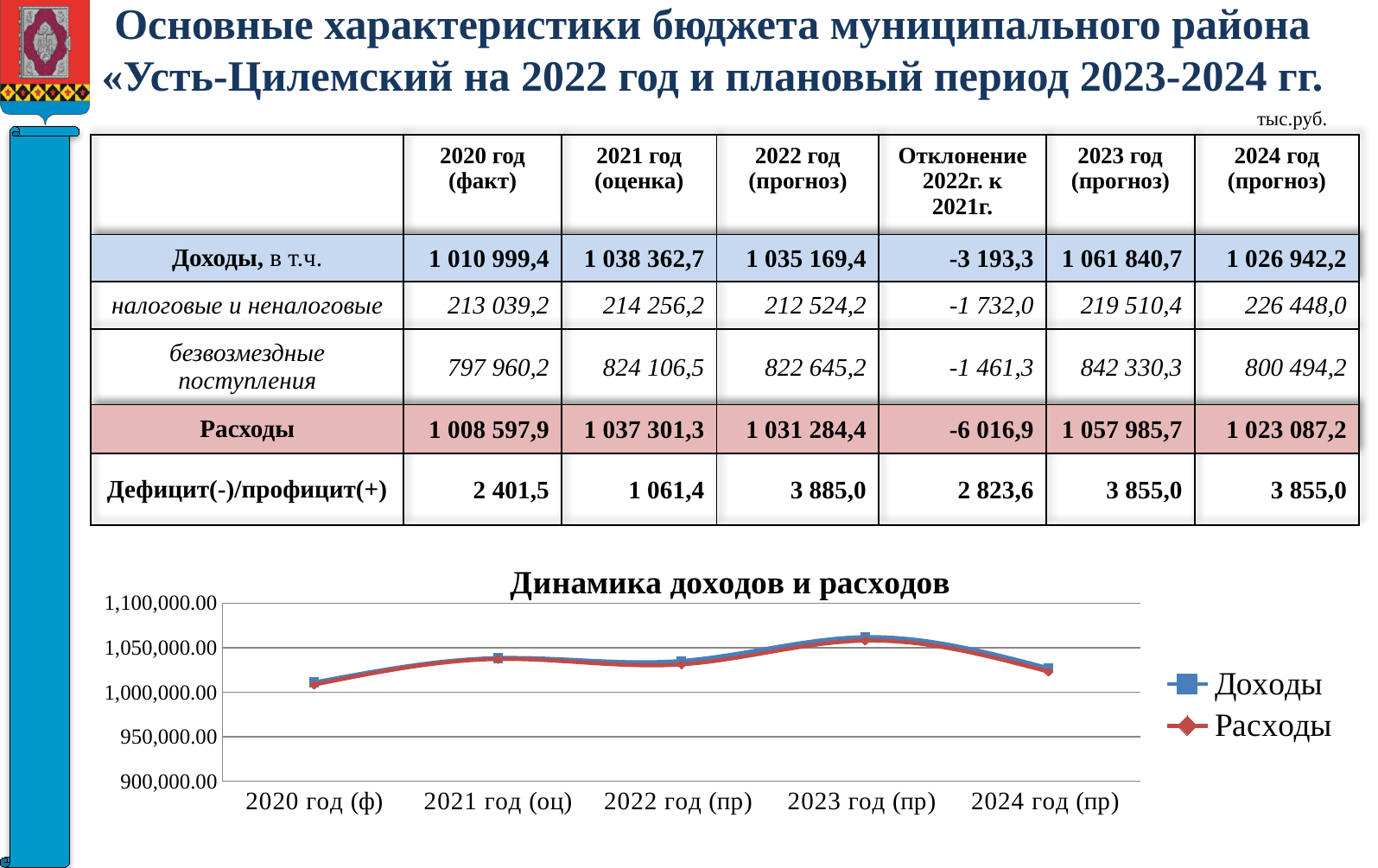
What kind of chart is shown under the title "Динамика доходов и расходов"? line chart In the chart "Динамика доходов и расходов", which series is drawn in red? Расходы In the chart "Динамика доходов и расходов", is the value for Расходы in 2020 год (ф) greater or less than 1,050,000.00? less In the chart "Динамика доходов и расходов", do the Доходы values rise or fall from 2023 год (пр) to 2024 год (пр)? fall In the chart "Динамика доходов и расходов", which year has the highest value for Расходы? 2023 год (пр) In the chart "Динамика доходов и расходов", do the Расходы values rise or fall from 2020 год (ф) to 2021 год (оц)? rise How many points are plotted along the x axis of the chart "Динамика доходов и расходов" for each series? 5 In the chart "Динамика доходов и расходов", is the value for Доходы in 2023 год (пр) greater or less than 1,050,000.00? greater How many series does the legend of the chart "Динамика доходов и расходов" list? 2 In the chart "Динамика доходов и расходов", is the value for Доходы in 2020 год (ф) greater or less than 1,000,000.00? greater In the chart "Динамика доходов и расходов", which year has the highest value for Доходы? 2023 год (пр) In the chart "Динамика доходов и расходов", which year has the lowest value for Расходы? 2020 год (ф)